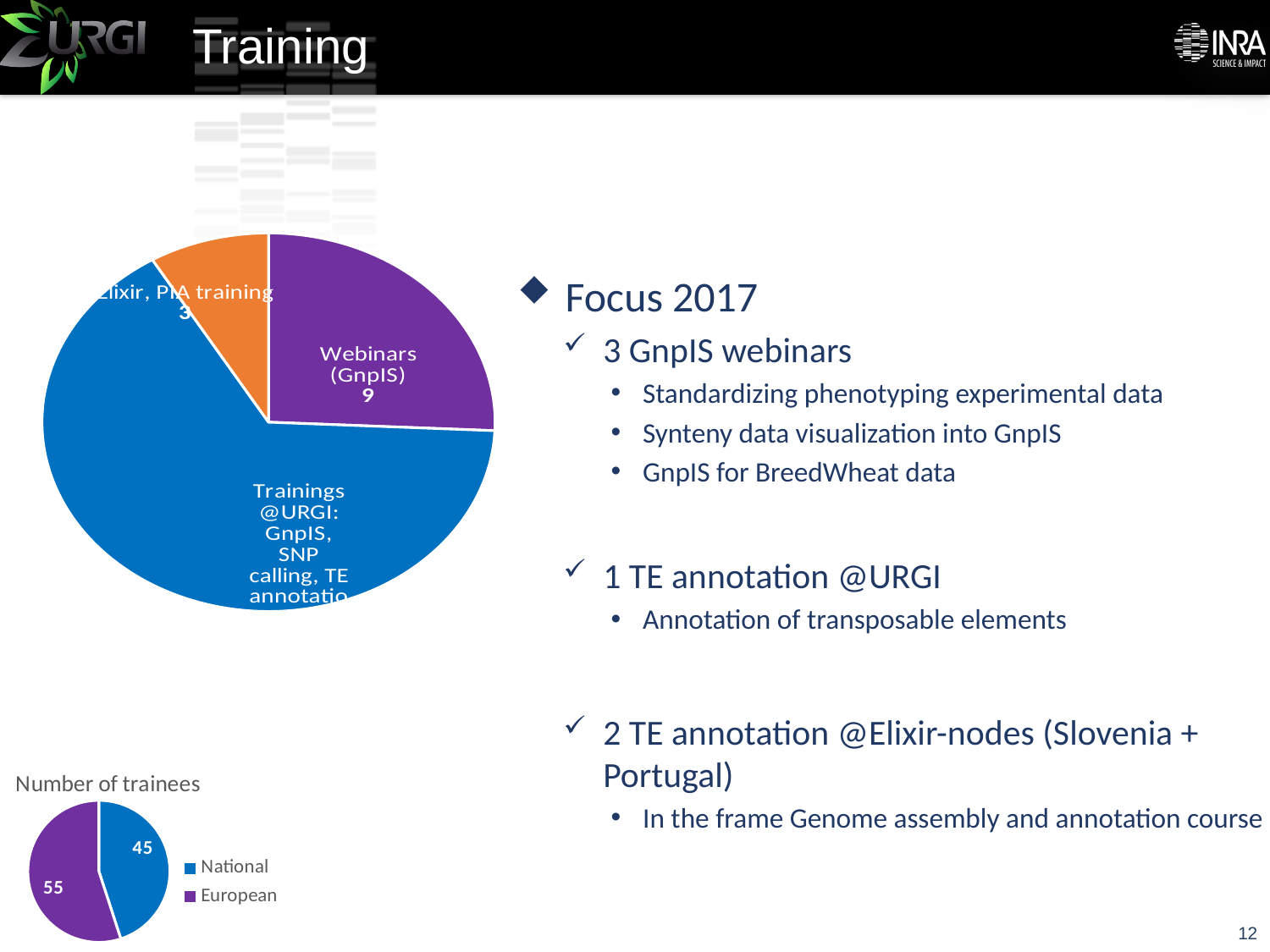
What type of chart is the 'Number of trainees' chart? Pie chart In the top pie chart, what is the value for the Elixir, PIA training slice? 3 In the 'Number of trainees' chart, what is the value for National? 45 In the top pie chart, which is larger: Webinars (GnpIS) or Elixir, PIA training? Webinars (GnpIS) In the top pie chart, which slice is the largest? Trainings @URGI: GnpIS, SNP calling, TE annotation In the top pie chart, which slice is the smallest? Elixir, PIA training How many slices does the top pie chart have? 3 In the 'Number of trainees' chart, what share of the total do European trainees represent? 55% In the 'Number of trainees' chart, what is the value for European? 55 In the top pie chart, what is the difference between the Webinars (GnpIS) value and the Elixir, PIA training value? 6 In the 'Number of trainees' chart, which category is larger, National or European? European In the top pie chart, how many webinars (GnpIS) are shown? 9